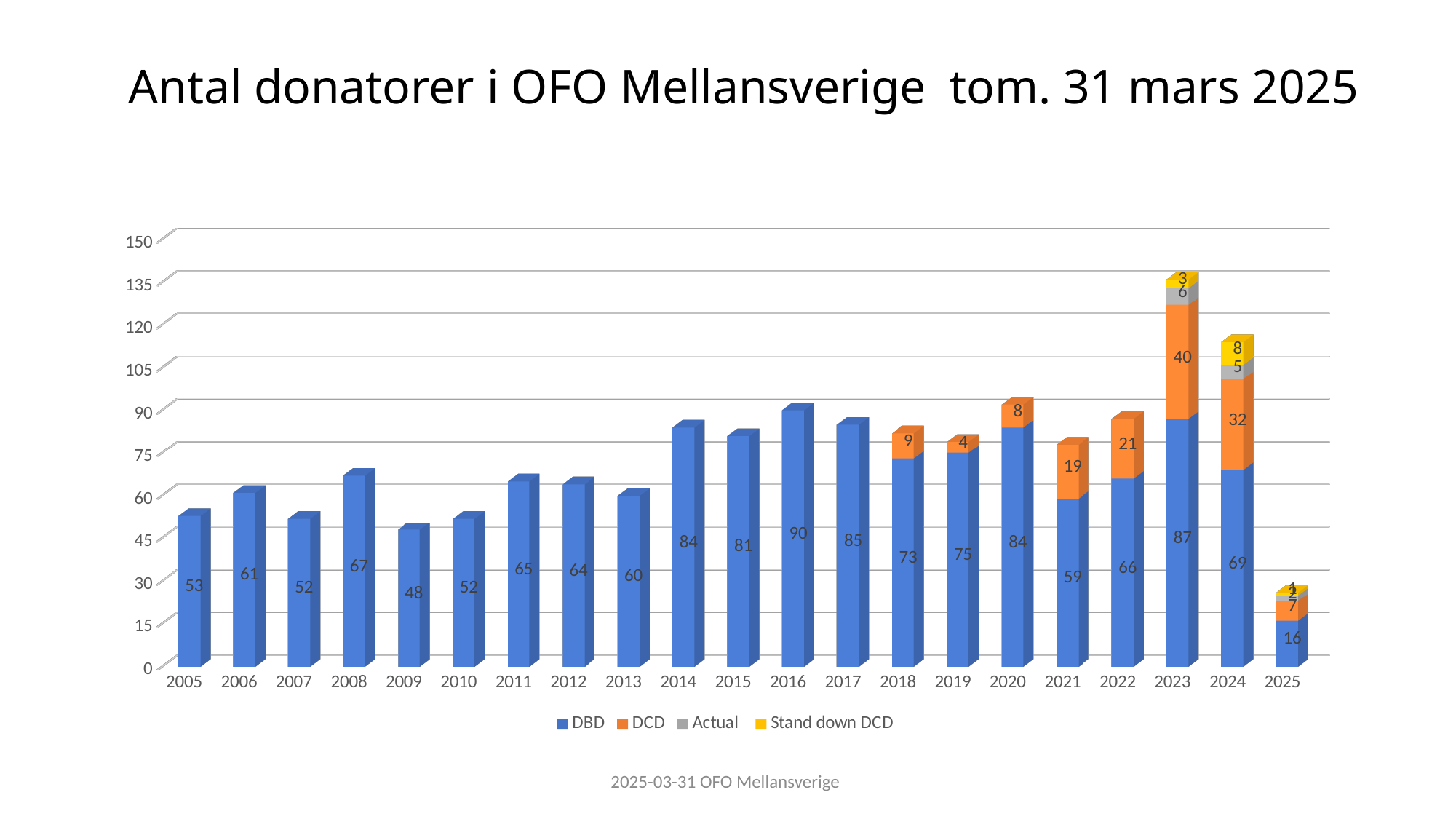
Which year has the lowest DBD value? 2025 What is the DBD value for 2016? 90 How many series does the legend list? 4 What is the difference between the DBD values for 2008 and 2009? 19 What is the total of the stacked bar for 2023? 136 What is the DCD value for 2023? 40 Which year has the larger DCD value, 2021 or 2022? 2022 Which year has the highest DBD value? 2016 What is the Stand down DCD value for 2024? 8 How many years are shown on the x axis? 21 What is the title of the chart? Antal donatorer i OFO Mellansverige tom. 31 mars 2025 What kind of chart is shown on the slide? Stacked bar chart